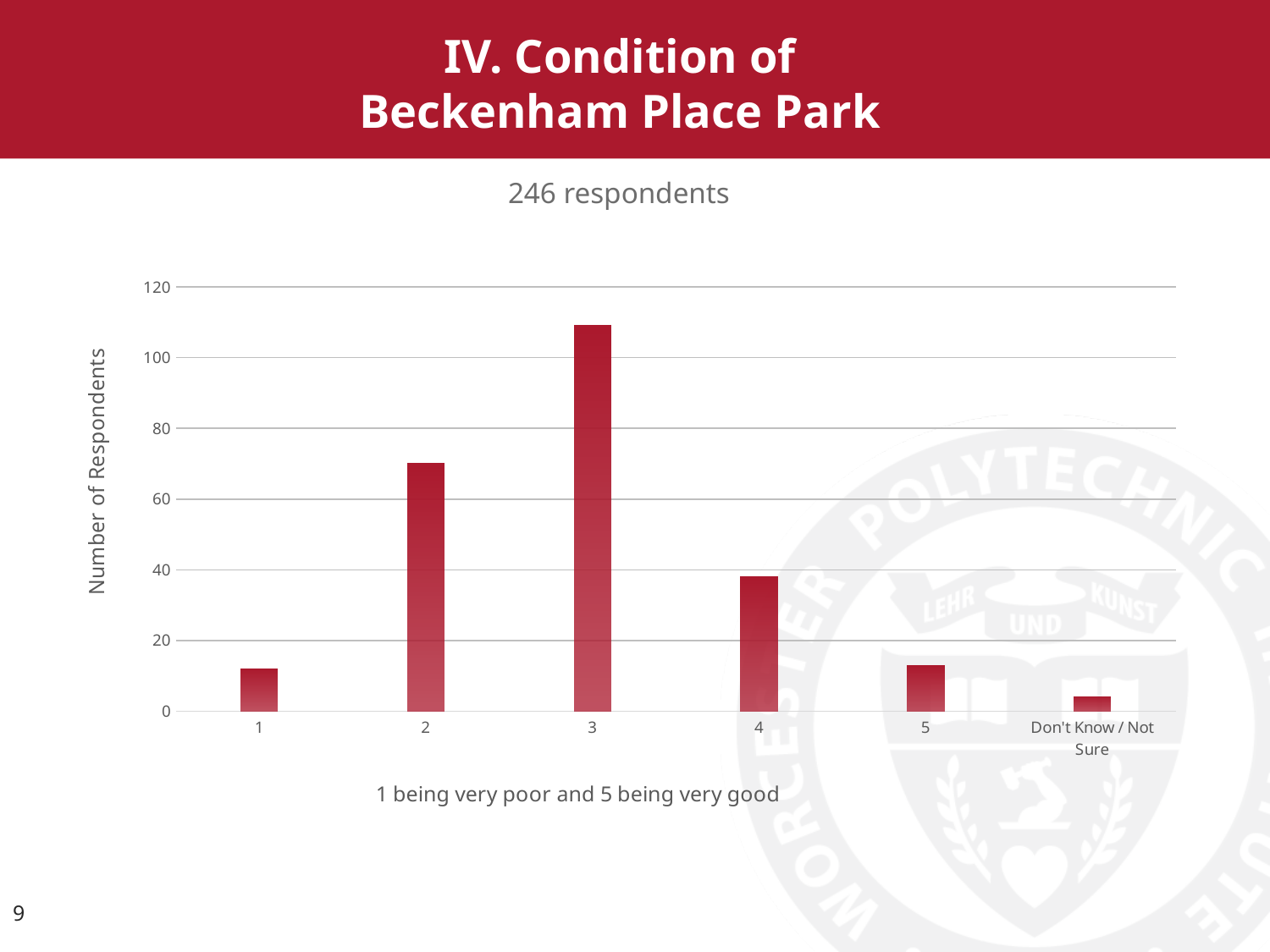
What is the label of the y axis? Number of Respondents Is the number of respondents for rating 2 greater or less than 80? less Is the number of respondents for rating 2 greater or less than 60? greater Which rating category has the highest number of respondents? 3 Which has more respondents, rating 2 or rating 4? 2 Which category has the lowest number of respondents? Don't Know / Not Sure How many categories are shown on the x axis? 6 How many respondents does the slide say took part in the survey? 246 respondents Is the number of respondents for rating 4 greater or less than 20? greater What kind of chart is shown on the slide? bar chart